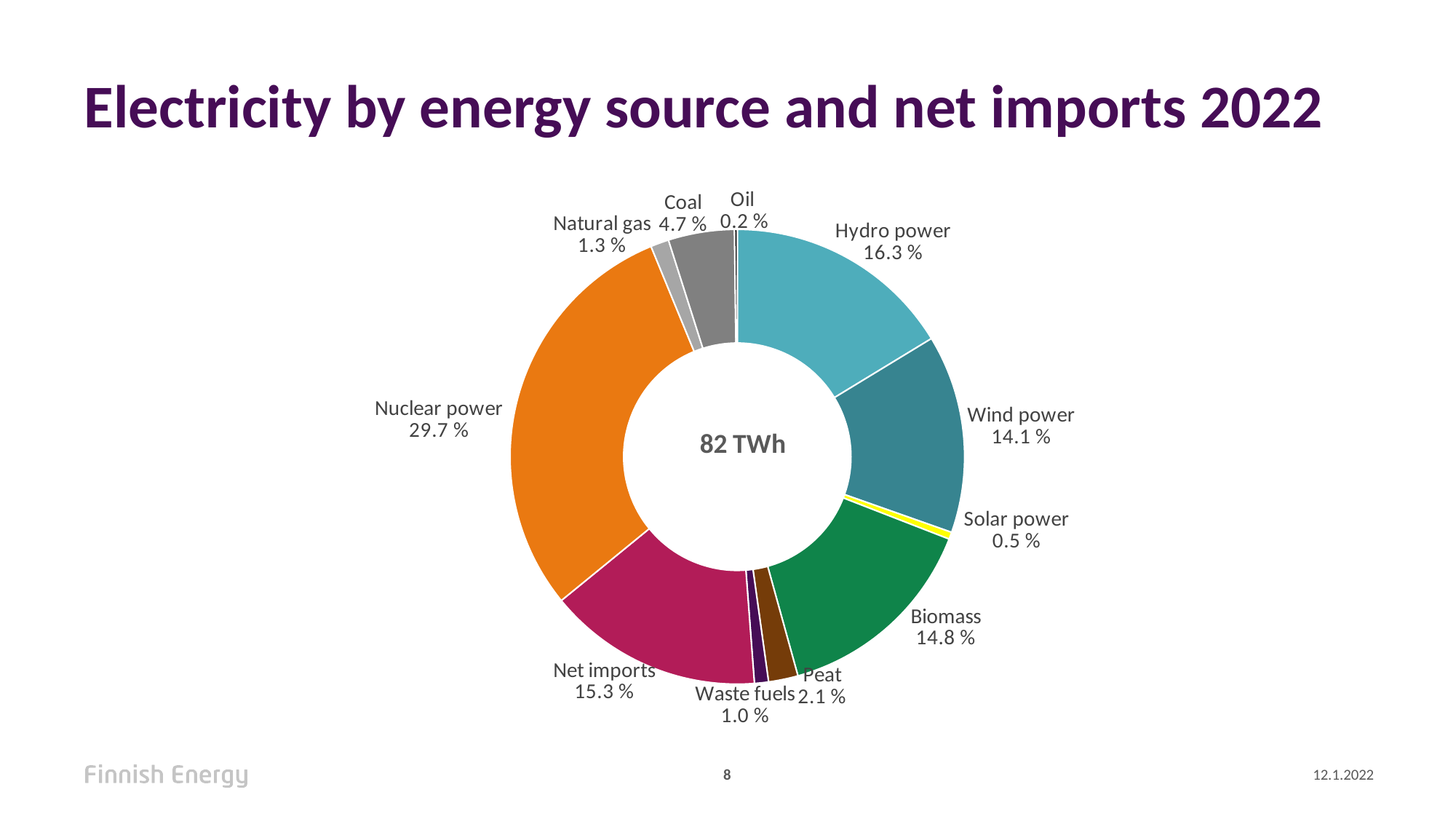
What kind of chart is shown on the slide? Pie chart (doughnut) Which category has the smallest share in the chart? Oil What share of electricity does Nuclear power account for? 29.7 % Which energy source has the largest share in the chart? Nuclear power What is the share for Solar power? 0.5 % What is the difference in percentage points between Hydro power and Wind power? 2.2 What total is printed in the centre of the chart? 82 TWh What percentage is shown for Net imports? 15.3 % What is the title of the chart on the slide? Electricity by energy source and net imports 2022 What is the value shown for Wind power? 14.1 % How many categories are shown in the chart? 11 Which is larger, the share of Biomass or the share of Wind power? Biomass